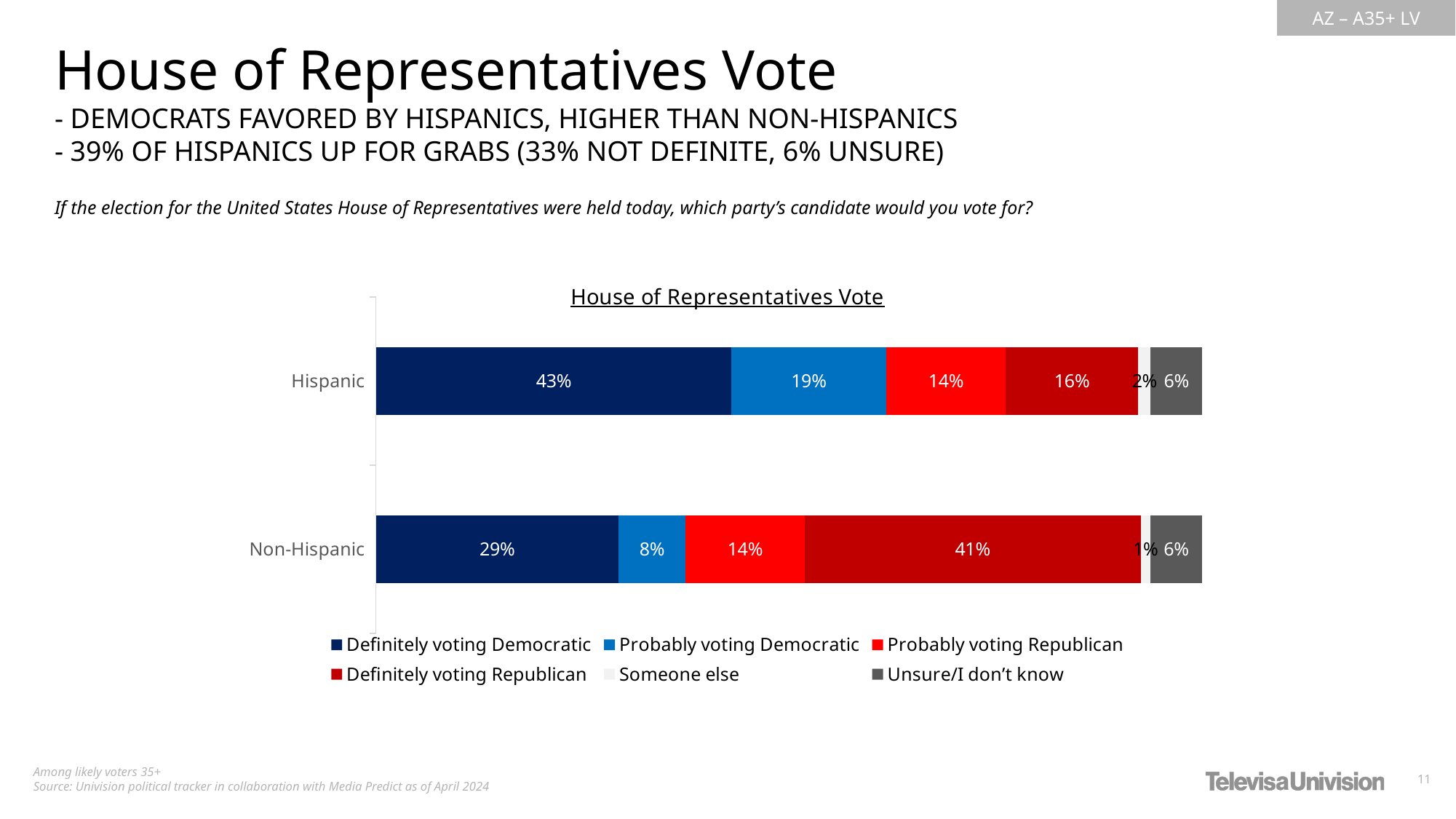
What percentage of Non-Hispanic respondents are unsure/don't know? 6% Which response category is the largest for Non-Hispanic respondents? Definitely voting Republican Which response category is the smallest for Hispanic respondents? Someone else What is the difference between the Non-Hispanic and Hispanic shares definitely voting Republican? 25% Which group has the higher share definitely voting Democratic, Hispanic or Non-Hispanic? Hispanic How many series does the legend list? 6 What percentage of Non-Hispanic respondents are definitely voting Republican? 41% How many groups (categories) are shown on the chart? 2 What percentage of Hispanic respondents are definitely voting Democratic? 43% What percentage of Hispanic respondents are probably voting Democratic? 19% What is the difference between the Hispanic and Non-Hispanic shares probably voting Democratic? 11% What type of chart is shown on the slide? Stacked bar chart